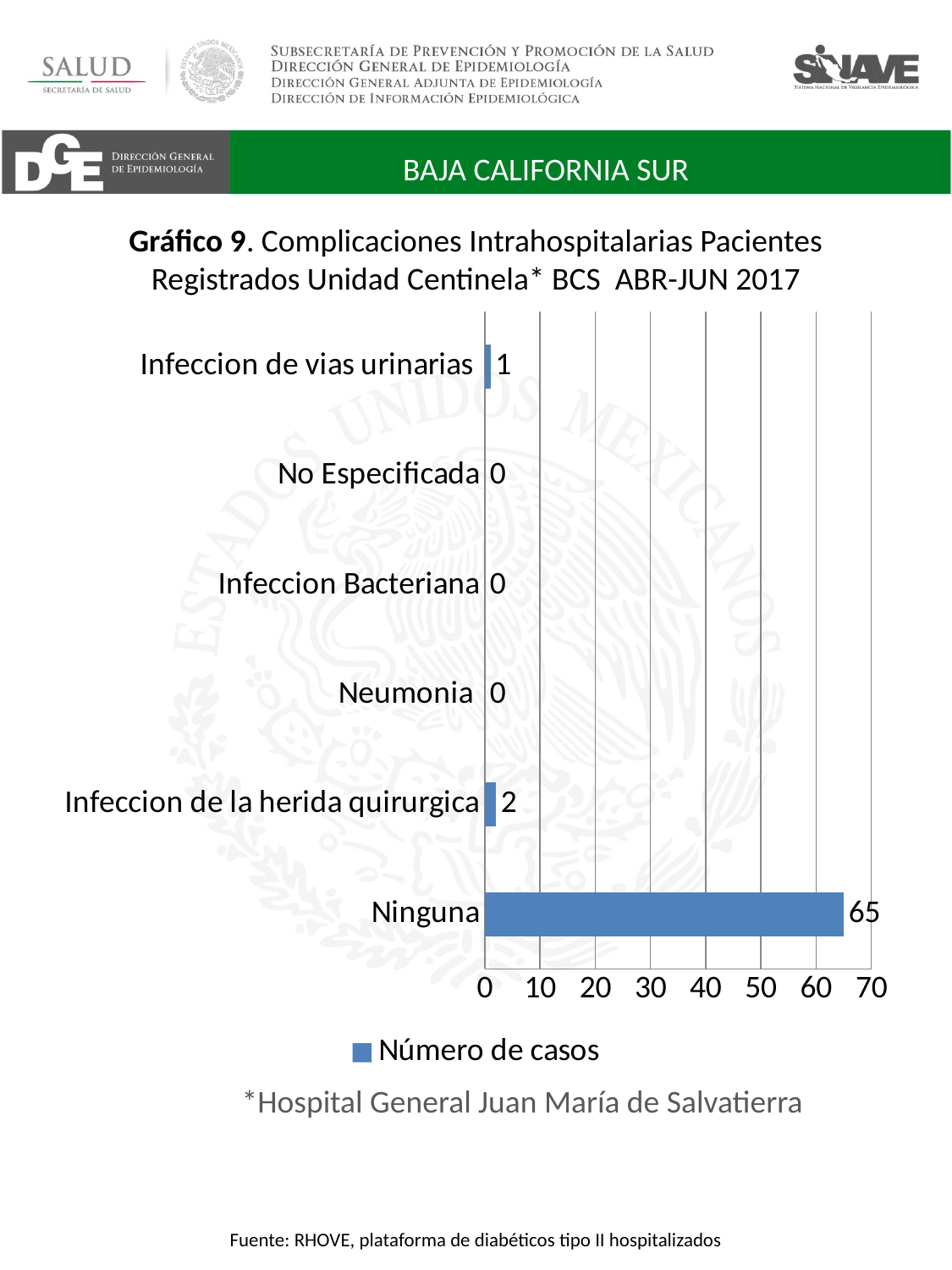
How many series does the legend list? 1 Is the value for Ninguna greater or less than 60? greater What is the difference in number of cases between Ninguna and Infeccion de la herida quirurgica? 63 What is the legend entry of the chart? Número de casos Which category has the highest number of cases? Ninguna What is the number of cases for Infeccion de vias urinarias? 1 Which has more cases, Infeccion de la herida quirurgica or Infeccion de vias urinarias? Infeccion de la herida quirurgica How many categories are shown on the chart? 6 What is the number of cases for Ninguna? 65 What is the number of cases for Neumonia? 0 What is the number of cases for Infeccion de la herida quirurgica? 2 What kind of chart is shown on the slide? bar chart